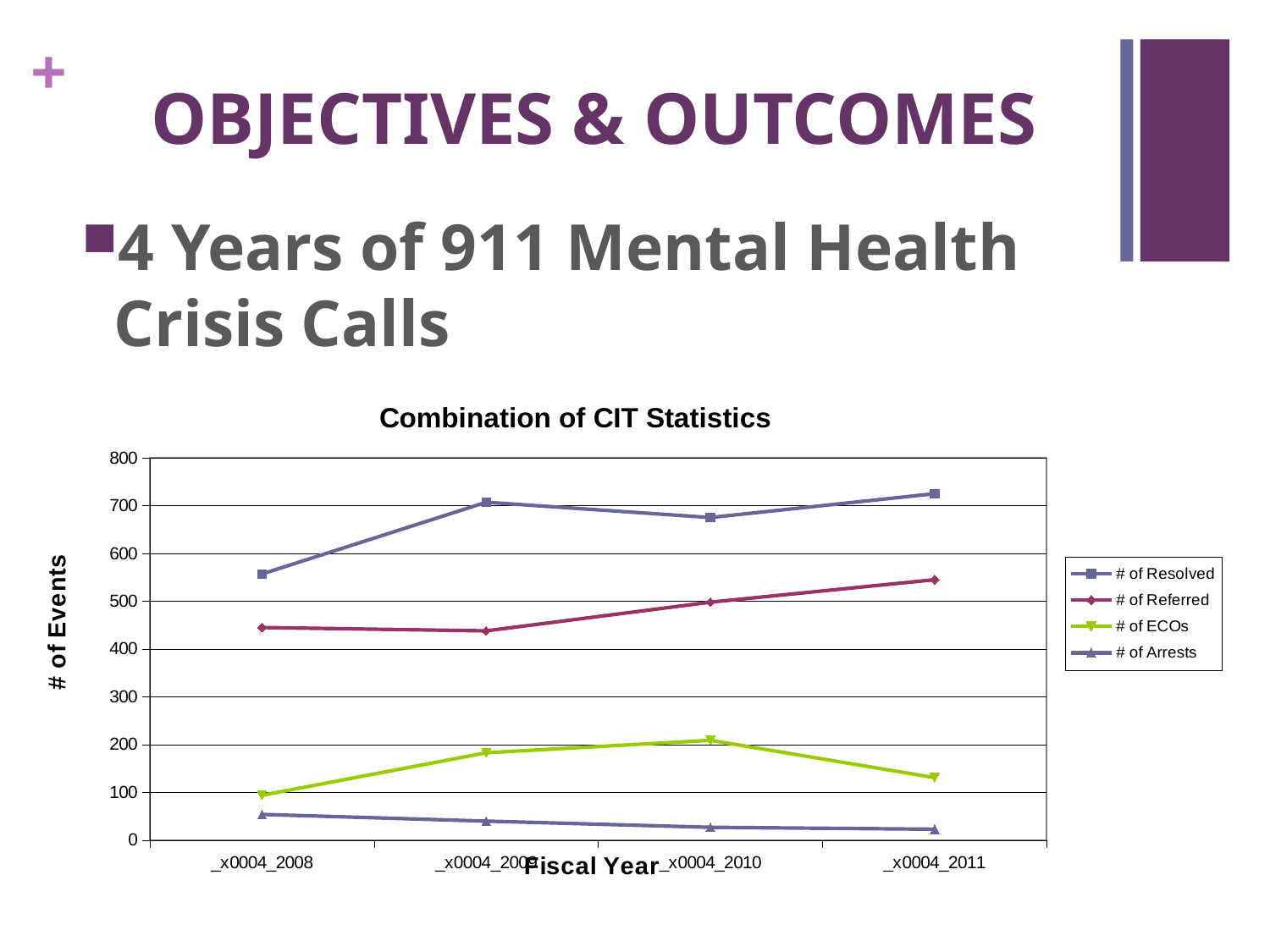
How many fiscal year categories are plotted along the x axis? 4 In which fiscal year category is # of Arrests highest? _x0004_2008 Is the value for # of Arrests at _x0004_2008 greater or less than 100? less What kind of chart is shown on the slide? line chart How many series does the legend of the chart list? 4 What is the title of the chart? Combination of CIT Statistics In which fiscal year category is # of Referred highest? _x0004_2011 What is the label on the vertical axis of the chart? # of Events At _x0004_2010, which is larger: # of Resolved or # of Referred? # of Resolved Is the value for # of Referred at _x0004_2011 greater or less than 500? greater Does the # of Arrests series rise or fall from _x0004_2008 to _x0004_2011? fall Is the value for # of Resolved at _x0004_2008 greater or less than 600? less